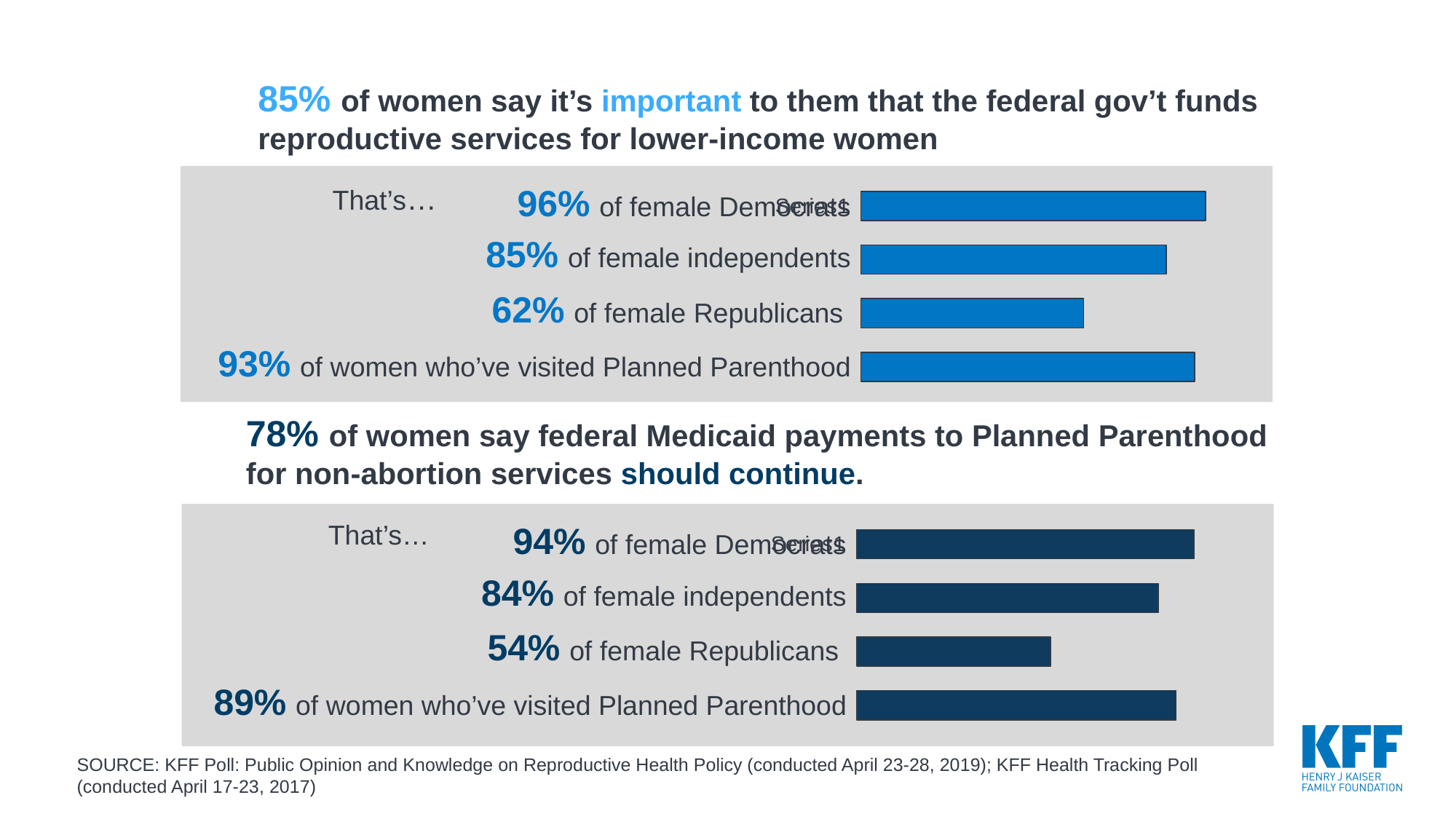
How many bars are in the top chart? 4 In the top chart, which group has the lowest value? Female Republicans In the bottom chart, which group has the highest value? Female Democrats In the bottom chart, what is the value for female independents? 84% In the top chart, what is the difference between the values for female Democrats and female Republicans? 34 percentage points What colour are the bars in the top chart? Blue In the bottom chart, which is larger: the value for female Democrats or the value for women who've visited Planned Parenthood? Female Democrats In the bottom chart, what is the difference between the values for female independents and female Republicans? 30 percentage points In the top chart, what percentage of female Democrats say it's important that the federal government funds reproductive services for lower-income women? 96% In the bottom chart, what percentage of women who've visited Planned Parenthood say federal Medicaid payments to Planned Parenthood should continue? 89% What kind of chart is the bottom chart? Bar chart In the top chart, what is the value for female Republicans? 62%